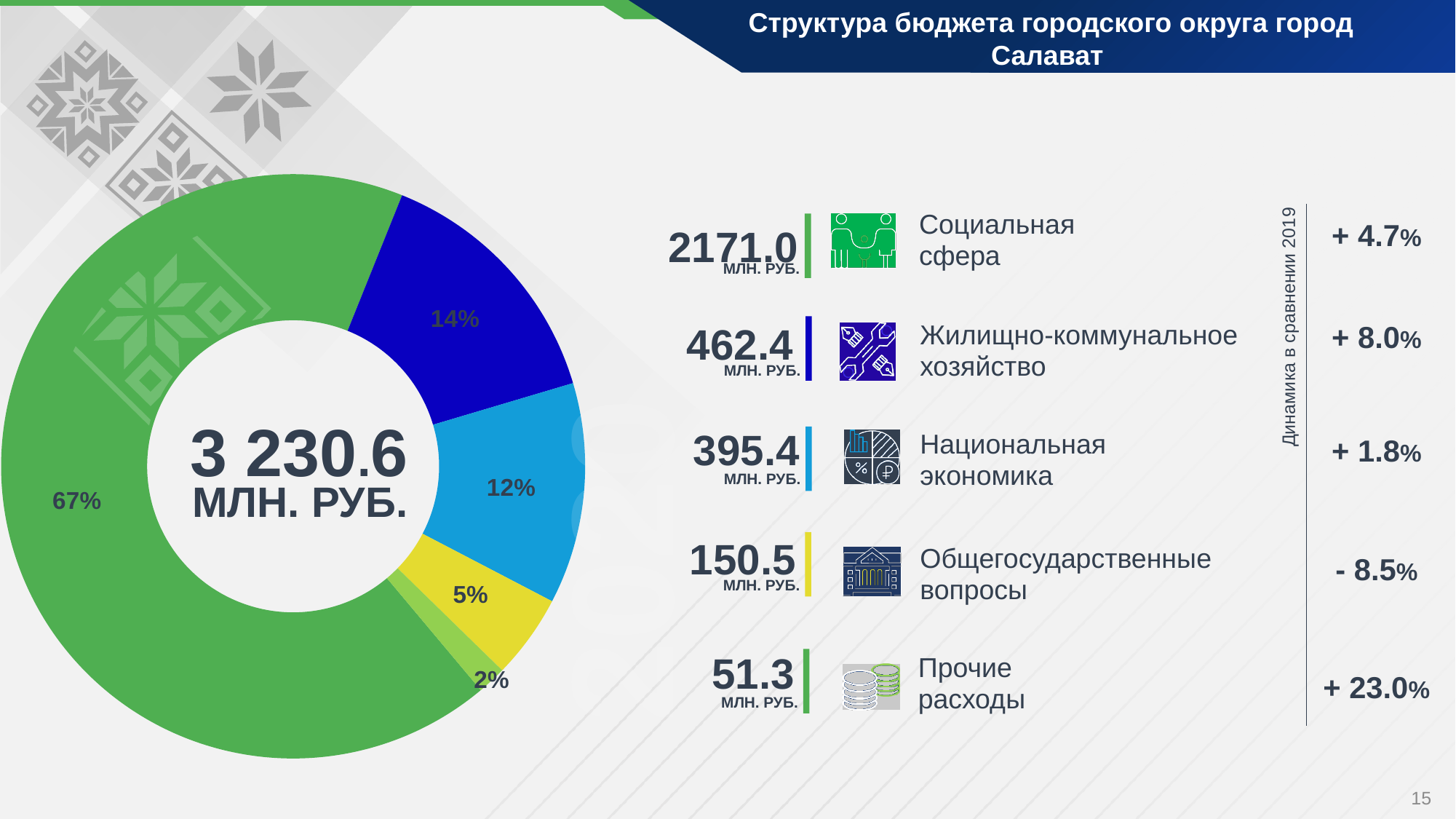
What share of the pie does the 'Национальная экономика' slice represent? 12% What share of the pie does the 'Социальная сфера' slice represent? 67% What kind of chart is shown on the slide? Pie (donut) chart What is the difference in percentage points between the 'Жилищно-коммунальное хозяйство' slice and the 'Национальная экономика' slice? 2% What total value is printed in the centre of the donut chart? 3 230.6 млн. руб. What is the value shown for 'Общегосударственные вопросы'? 150.5 млн. руб. What share of the pie does the 'Жилищно-коммунальное хозяйство' slice represent? 14% Which category has the largest slice of the pie? Социальная сфера Which is larger: the value for 'Жилищно-коммунальное хозяйство' or the value for 'Национальная экономика'? Жилищно-коммунальное хозяйство Which category has the smallest slice of the pie? Прочие расходы How many slices does the pie chart have? 5